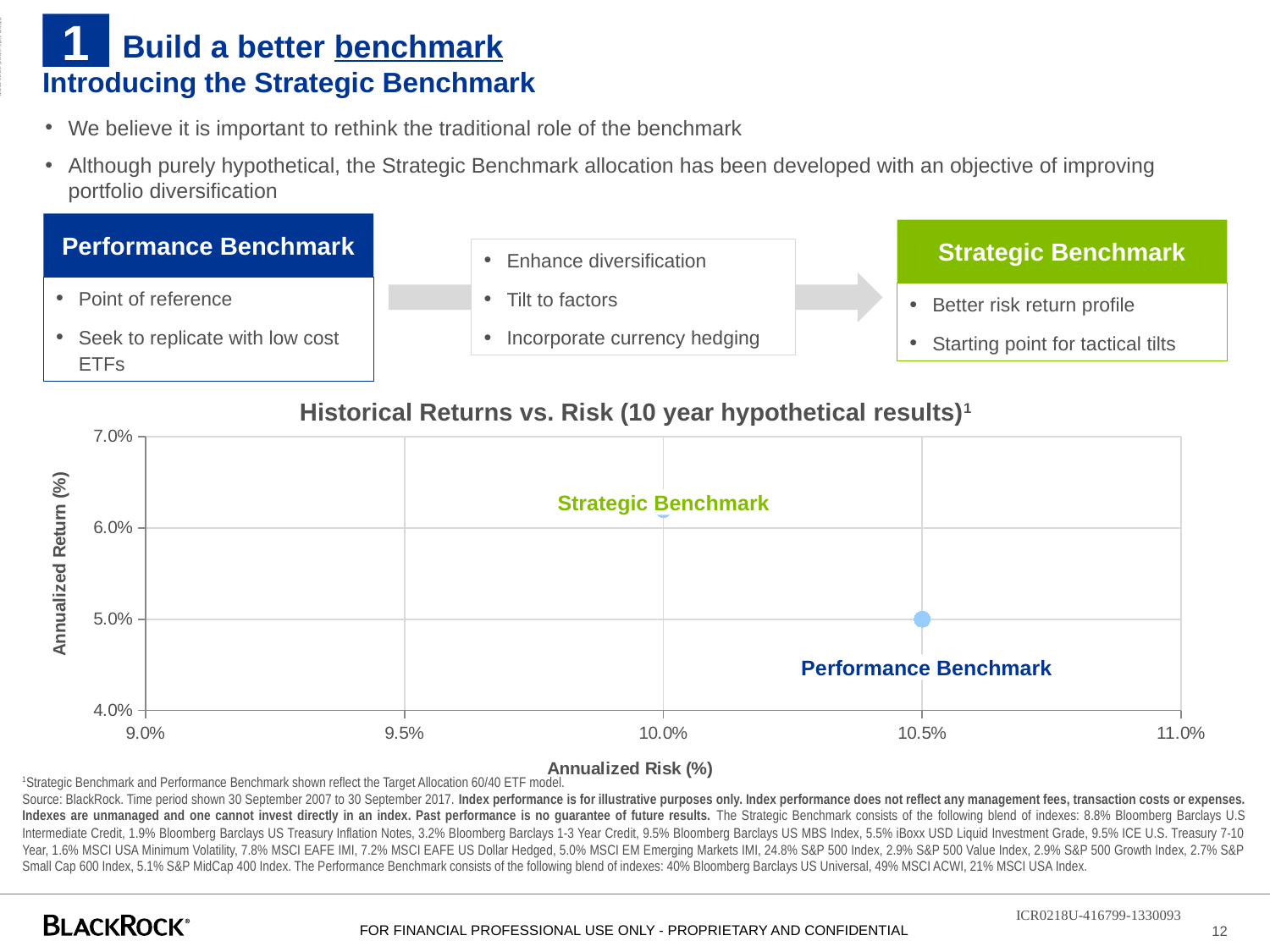
Which benchmark has the higher annualized return on the chart, Strategic Benchmark or Performance Benchmark? Strategic Benchmark What is the title of the chart on the slide? Historical Returns vs. Risk (10 year hypothetical results) Is the annualized risk for the Performance Benchmark greater or less than 10.0%? greater What kind of chart is shown under the title 'Historical Returns vs. Risk (10 year hypothetical results)'? Scatter chart Is the annualized return for the Strategic Benchmark greater or less than 5.0%? greater What is the label of the horizontal axis of the chart? Annualized Risk (%) Which point on the chart has the highest annualized return? Strategic Benchmark Which point on the chart has the lowest annualized risk? Strategic Benchmark Which benchmark has the higher annualized risk on the chart, Strategic Benchmark or Performance Benchmark? Performance Benchmark How many data points are plotted on the Historical Returns vs. Risk chart? 2 Is the annualized return for the Performance Benchmark greater or less than 6.0%? less